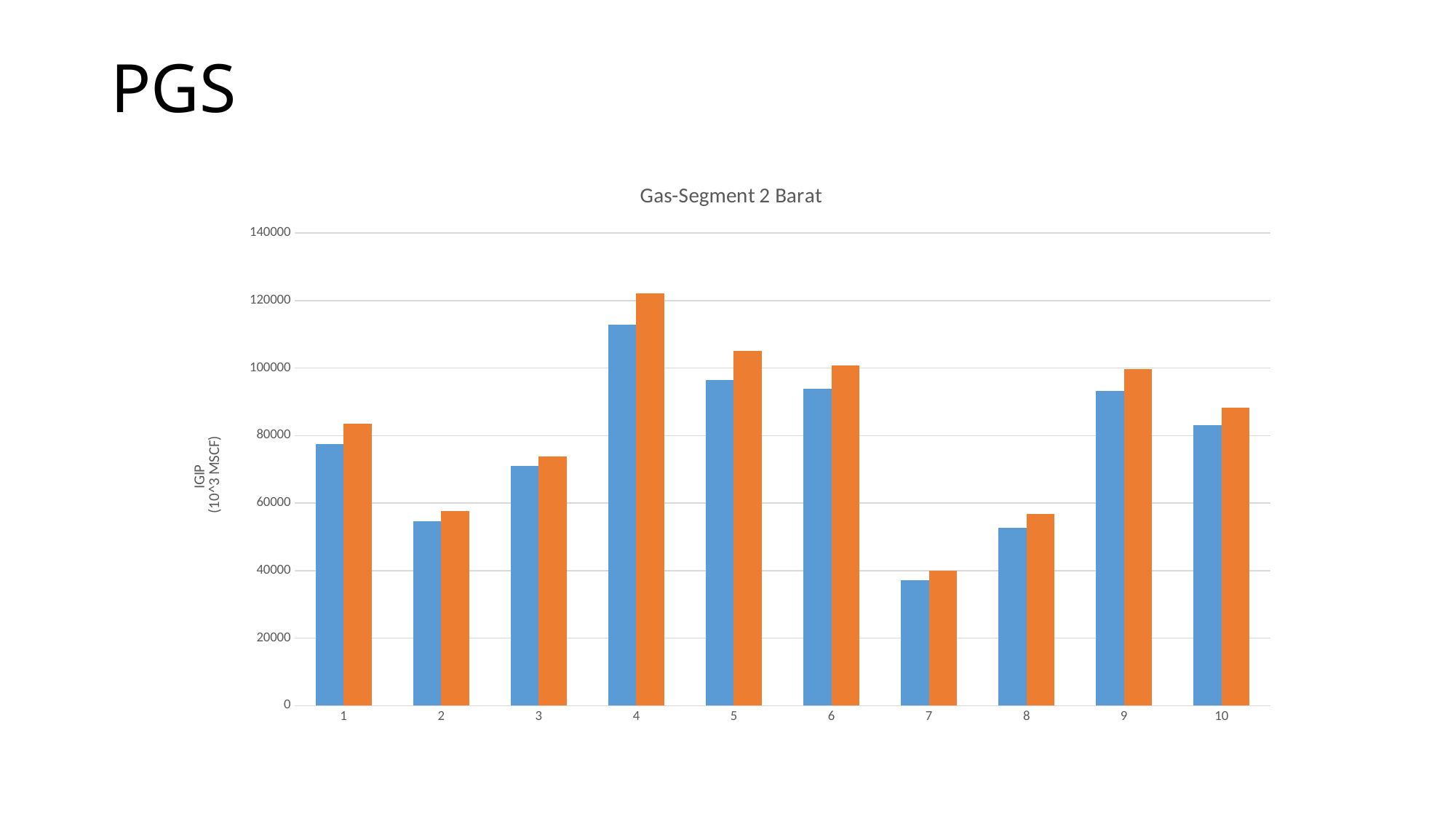
Which category has the lowest blue bar? 7 Which is larger, the orange bar for category 3 or the orange bar for category 8? category 3 What kind of chart is shown on the slide? bar chart How many categories are shown on the x axis of the chart? 10 What is the title of the chart? Gas-Segment 2 Barat Is the orange bar for category 5 greater or less than 100000? greater What is the label of the vertical axis? IGIP (10^3 MSCF) Is the blue bar for category 2 greater or less than 60000? less Is the blue bar for category 7 greater or less than 40000? less Which is larger, the blue bar for category 9 or the blue bar for category 10? category 9 Which category has the highest orange bar? 4